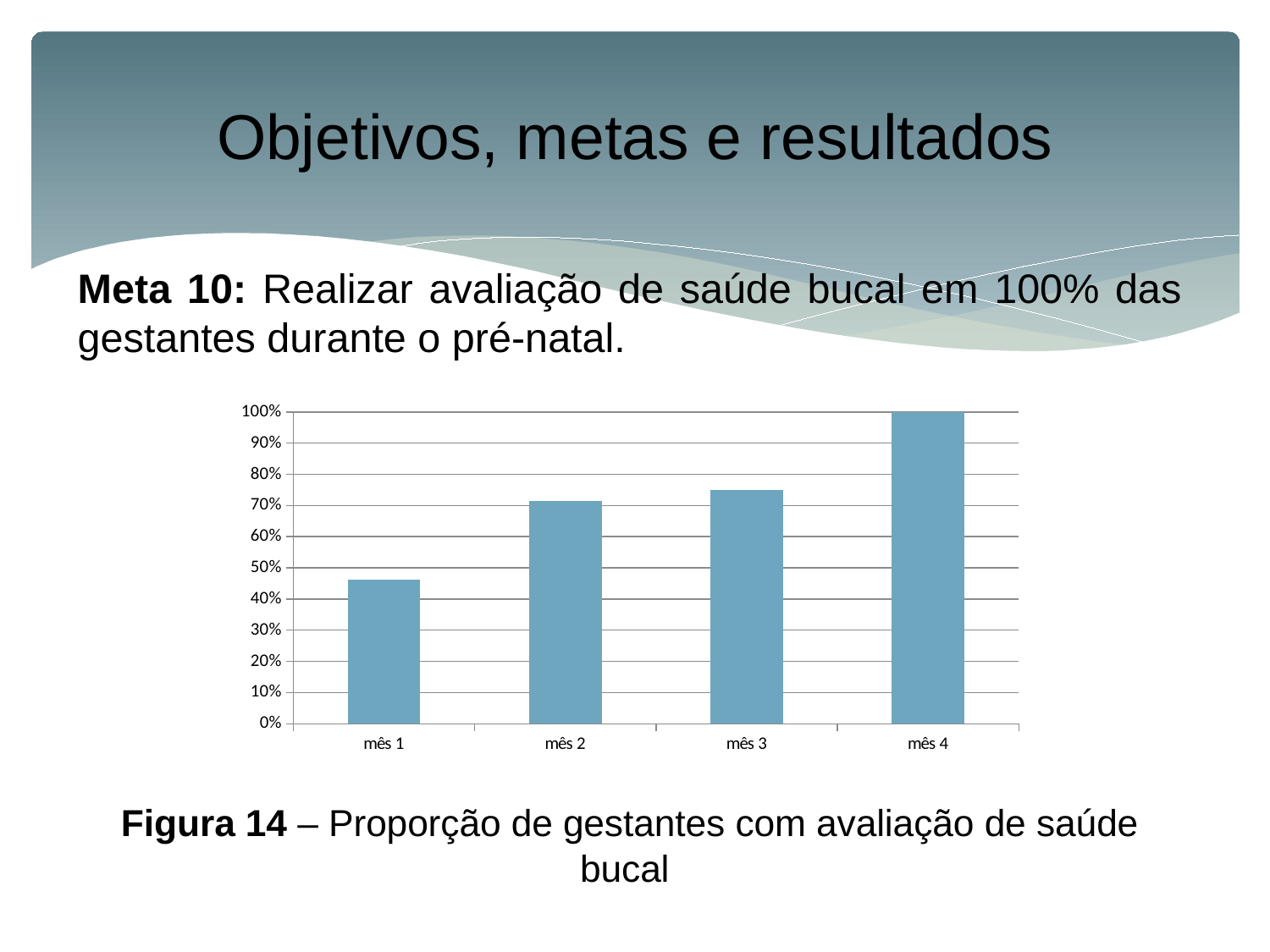
Is the value for mês 2 greater or less than 60%? greater Which month has the highest proportion of pregnant women with oral health evaluation? mês 4 Which month has the lowest proportion of pregnant women with oral health evaluation? mês 1 What is the figure number given in the caption below the chart? Figura 14 Which is larger, the value for mês 1 or the value for mês 2? mês 2 What is the highest value shown on the y axis of the chart? 100% How many categories (months) are shown on the x axis of the chart? 4 Is the value for mês 1 greater or less than 50%? less What kind of chart is shown on the slide? bar chart Do the values rise or fall from mês 1 to mês 4? rise Is the value for mês 3 greater or less than 80%? less What is the value for mês 4 in the chart? 100%